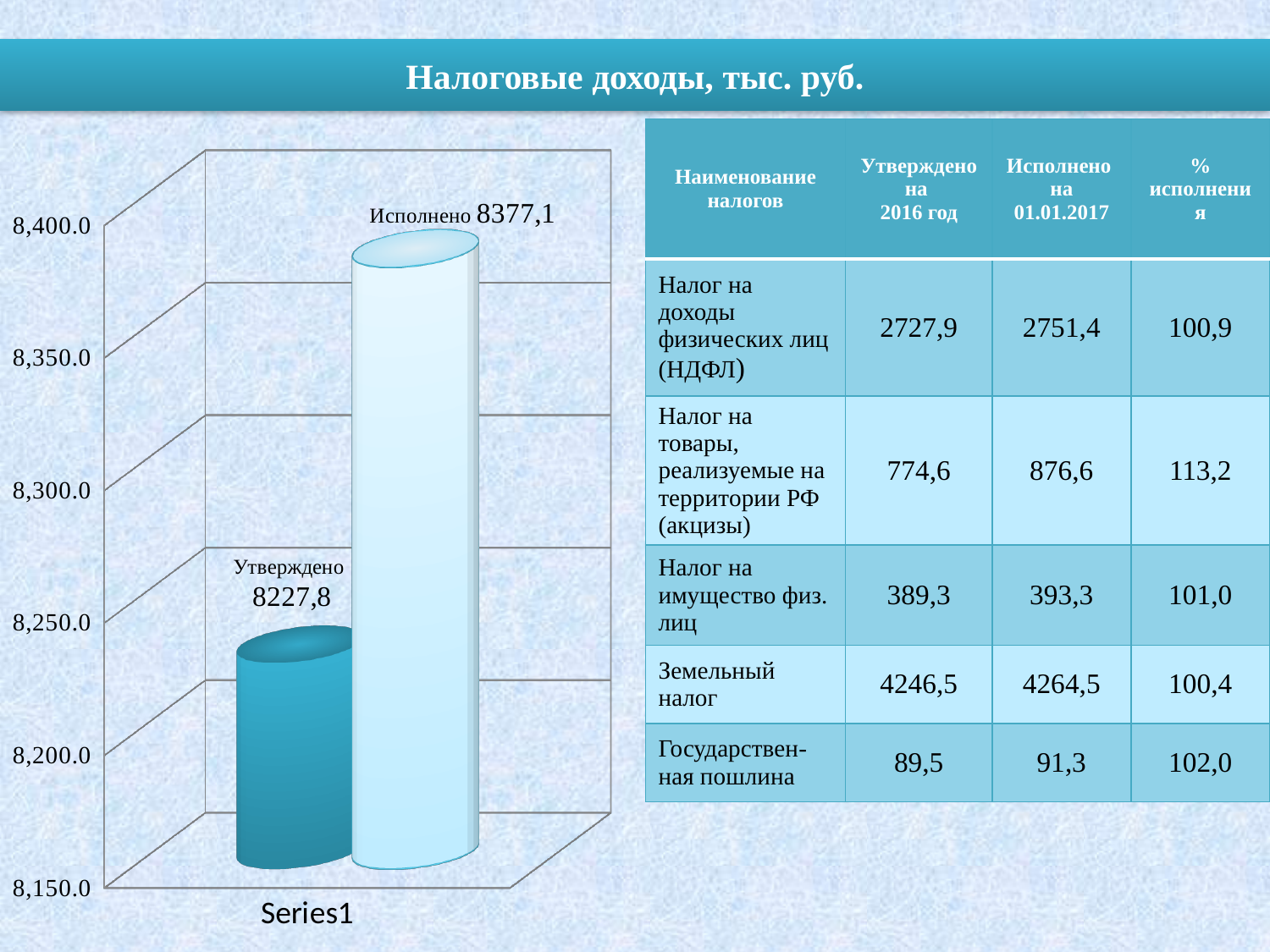
Which bar in the chart is the lowest? Утверждено Is the Исполнено value in the chart greater or less than 8,350.0? greater What label appears on the horizontal axis of the chart? Series1 What is the value of the Утверждено bar in the chart? 8227,8 What is the difference between the Исполнено and Утверждено values in the chart? 149,3 What is the title of the slide containing the chart? Налоговые доходы, тыс. руб. How many bars are plotted in the chart? 2 Which bar in the chart is higher, Утверждено or Исполнено? Исполнено Is the Утверждено value in the chart greater or less than 8,250.0? less What is the value of the Исполнено bar in the chart? 8377,1 What kind of chart is shown on the slide? bar chart Do the values in the chart rise or fall from Утверждено to Исполнено? rise